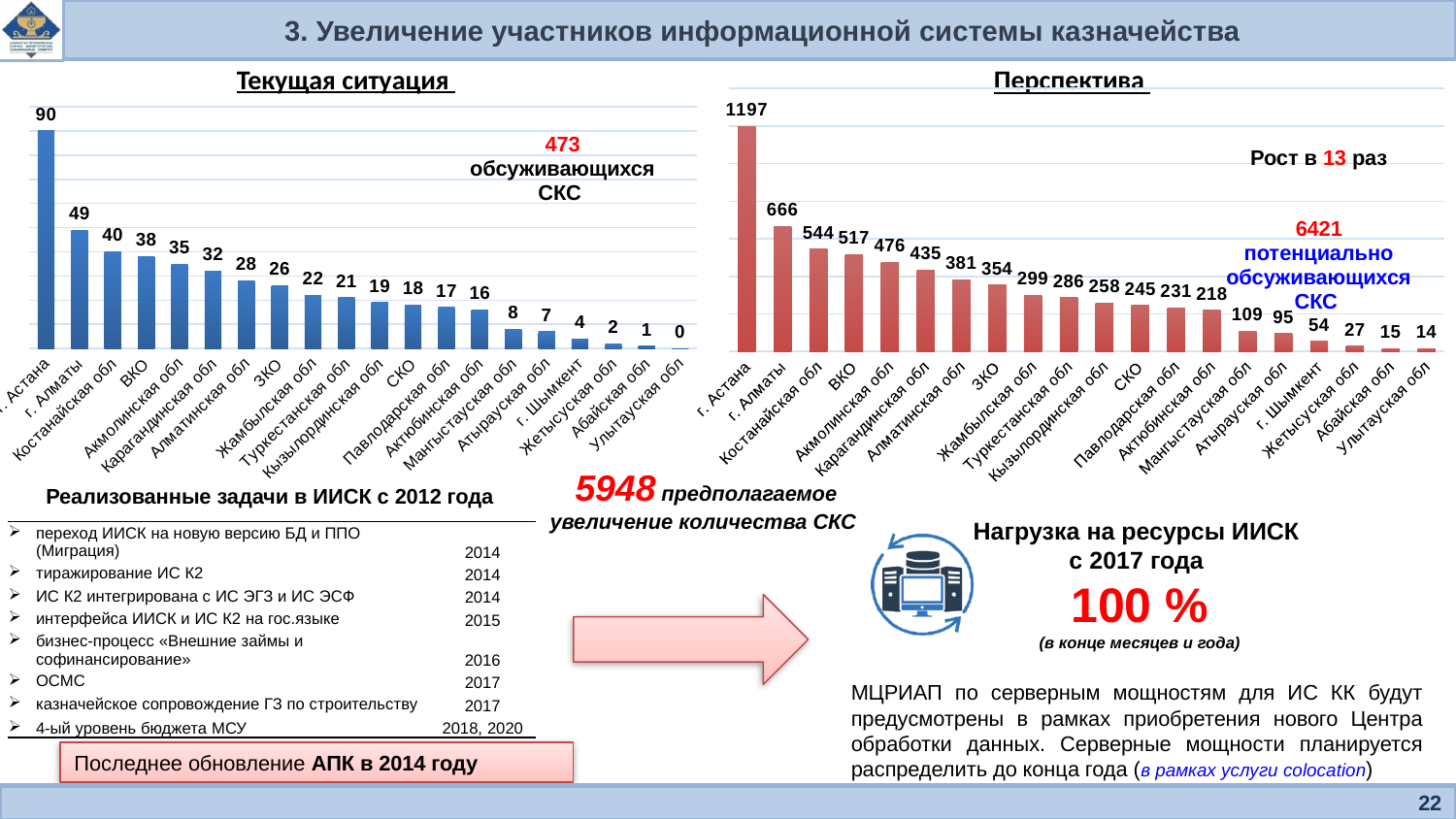
In the "Перспектива" chart, what is the value for ВКО? 517 What type of chart is the "Текущая ситуация" chart? Bar chart In the "Текущая ситуация" chart, what is the value for г. Алматы? 49 In the "Перспектива" chart, which category has the highest value? г. Астана How many categories are shown in the "Перспектива" chart? 20 In the "Текущая ситуация" chart, which category has the lowest value? Улытауская обл In the "Текущая ситуация" chart, which category has the highest value? г. Астана In the "Текущая ситуация" chart, what is the value for Карагандинская обл? 32 In the "Перспектива" chart, which is larger, the value for Жамбылская обл or the value for СКО? Жамбылская обл In the "Текущая ситуация" chart, what is the difference between the values for г. Астана and г. Алматы? 41 In the "Перспектива" chart, what is the value for Мангыстауская обл? 109 In the "Перспектива" chart, what is the difference between the values for г. Астана and г. Алматы? 531